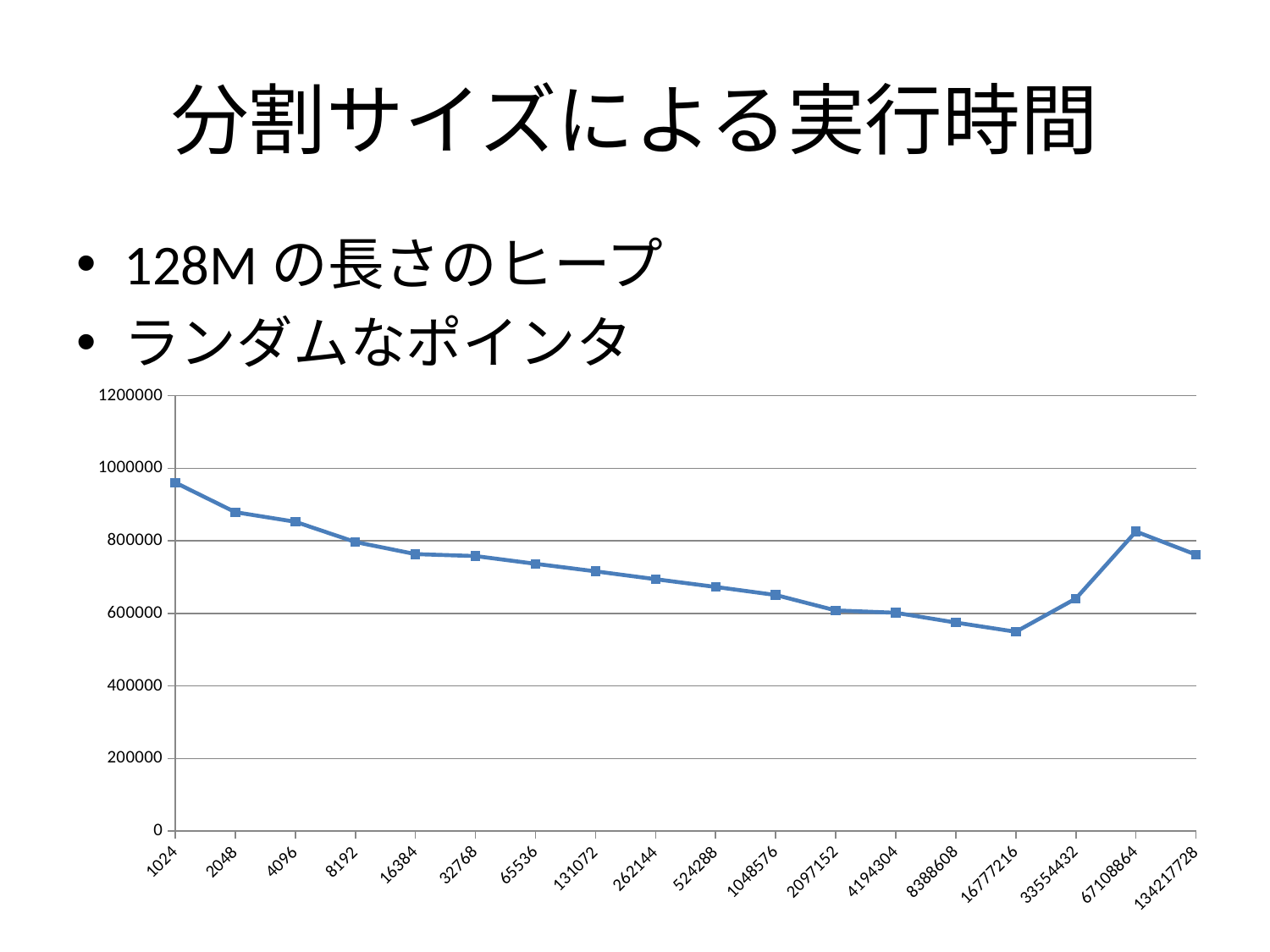
Is the value for 8192 greater or less than 1000000? less Do the values rise or fall from 1024 to 16777216? fall What kind of chart is shown on the slide? line chart Is the value for 1024 greater or less than 800000? greater Which x-axis category has the highest value? 1024 How many data points are plotted along the x axis? 18 What is the highest tick value shown on the y axis? 1200000 Is the value for 16777216 greater or less than 600000? less Which has the larger value, 33554432 or 67108864? 67108864 Which x-axis category has the lowest value? 16777216 Which has the larger value, 2048 or 8388608? 2048